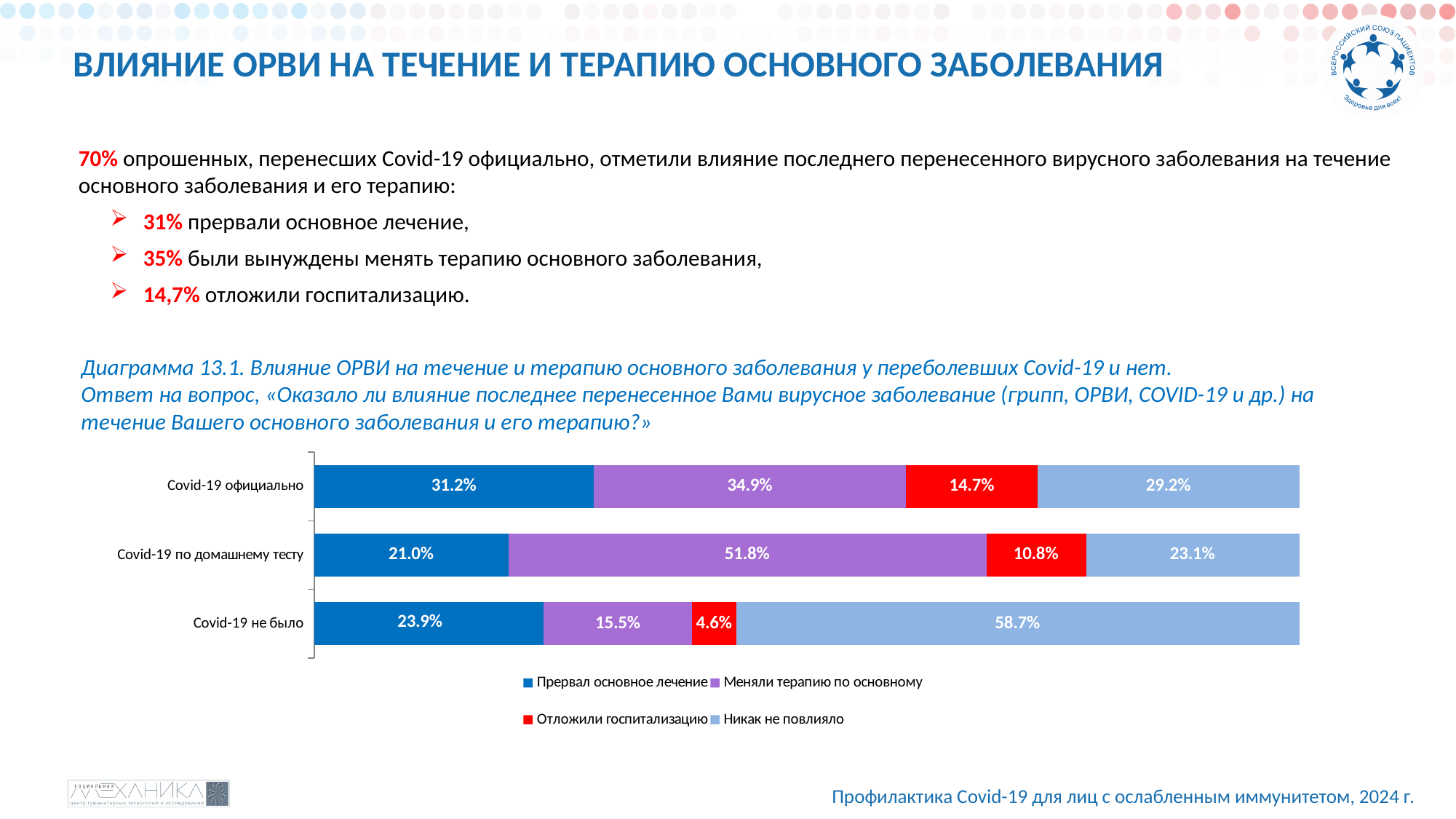
What is the value for "Прервал основное лечение" in the "Covid-19 официально" bar? 31.2% Which category has the highest value for "Отложили госпитализацию"? Covid-19 официально What is the value for "Меняли терапию по основному" in the "Covid-19 по домашнему тесту" bar? 51.8% How many categories (bars) are shown in the chart? 3 Which colour represents "Отложили госпитализацию" in the chart? Red How many series does the legend list? 4 Which is larger: "Прервал основное лечение" for "Covid-19 официально" or for "Covid-19 не было"? Covid-19 официально What is the value for "Никак не повлияло" in the "Covid-19 не было" bar? 58.7% What is the value for "Отложили госпитализацию" in the "Covid-19 не было" bar? 4.6% Which category has the lowest value for "Никак не повлияло"? Covid-19 по домашнему тесту What is the difference between the "Никак не повлияло" values for "Covid-19 не было" and "Covid-19 официально"? 29.5% What type of chart is shown on the slide? Stacked horizontal bar chart